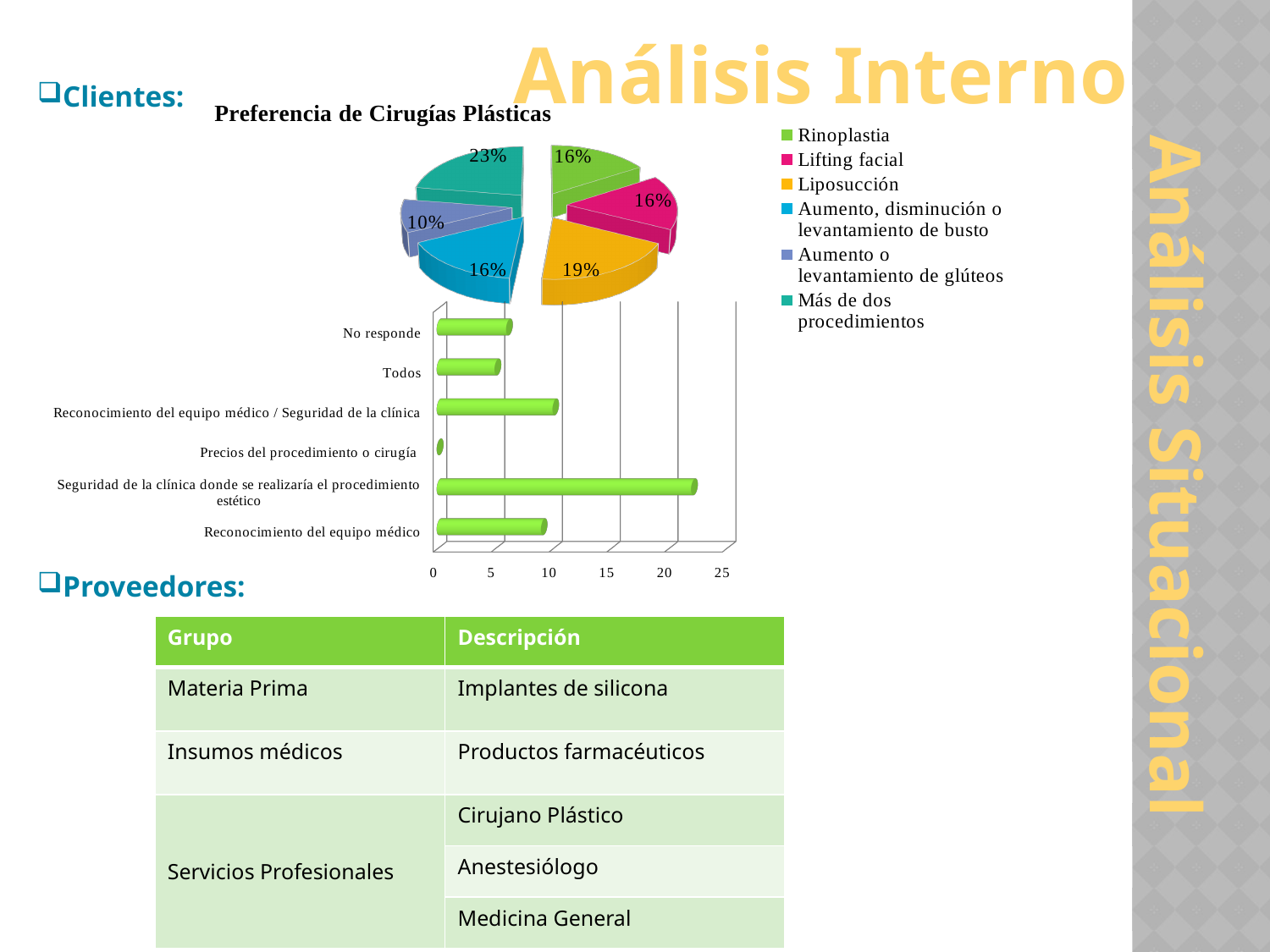
In the pie chart 'Preferencia de Cirugías Plásticas', how many categories does the legend list? 6 In the lower bar chart, which category has the longest bar? Seguridad de la clínica donde se realizaría el procedimiento estético In the pie chart 'Preferencia de Cirugías Plásticas', what is the difference in percentage points between Liposucción and Rinoplastia? 3 In the pie chart 'Preferencia de Cirugías Plásticas', what percentage is shown for Aumento o levantamiento de glúteos? 10% In the pie chart 'Preferencia de Cirugías Plásticas', what percentage is shown for Más de dos procedimientos? 23% In the lower bar chart, how many categories are shown? 6 In the lower bar chart, is the value for 'Seguridad de la clínica donde se realizaría el procedimiento estético' greater or less than 20? greater In the pie chart 'Preferencia de Cirugías Plásticas', what percentage is shown for Liposucción? 19% In the lower bar chart, which category has the shortest bar? Precios del procedimiento o cirugía In the pie chart 'Preferencia de Cirugías Plásticas', which category has the smallest share? Aumento o levantamiento de glúteos In the pie chart 'Preferencia de Cirugías Plásticas', which category has the largest share? Más de dos procedimientos What type of chart is the lower chart on the slide (the one with categories such as 'No responde' and 'Todos')? Bar chart